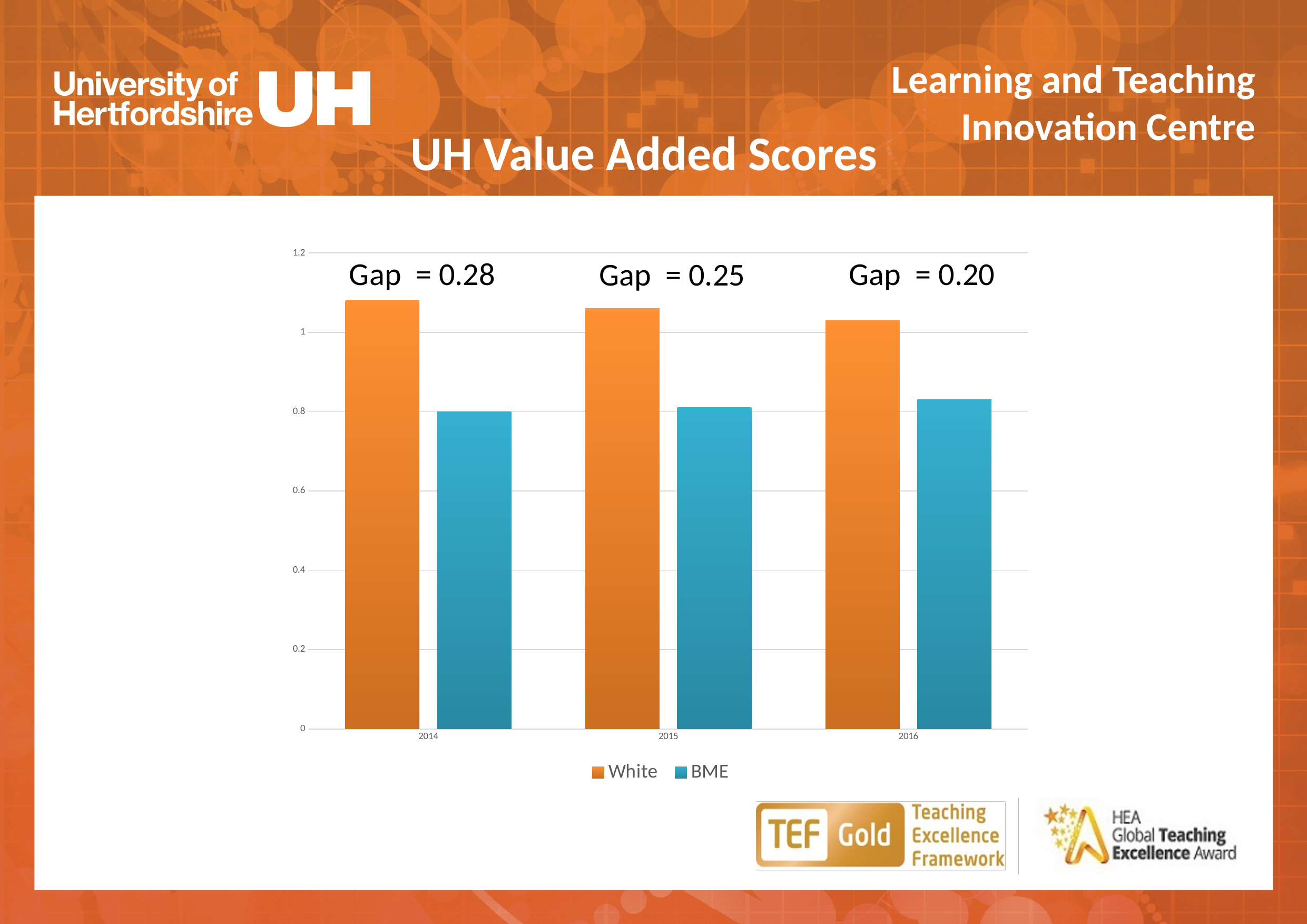
How many series does the legend list? 2 Is the value for BME in 2014 greater or less than 1? less How many years are shown on the x axis? 3 Is the value for White in 2014 greater or less than 1? greater What gap is shown for 2015? 0.25 What gap is shown for 2014? 0.28 In which year is the gap between White and BME smallest? 2016 What kind of chart is shown on the slide? bar chart Which is larger in 2015, the White value or the BME value? White Do the White values rise or fall from 2014 to 2016? fall What gap is shown for 2016? 0.20 In which year is the gap between White and BME largest? 2014